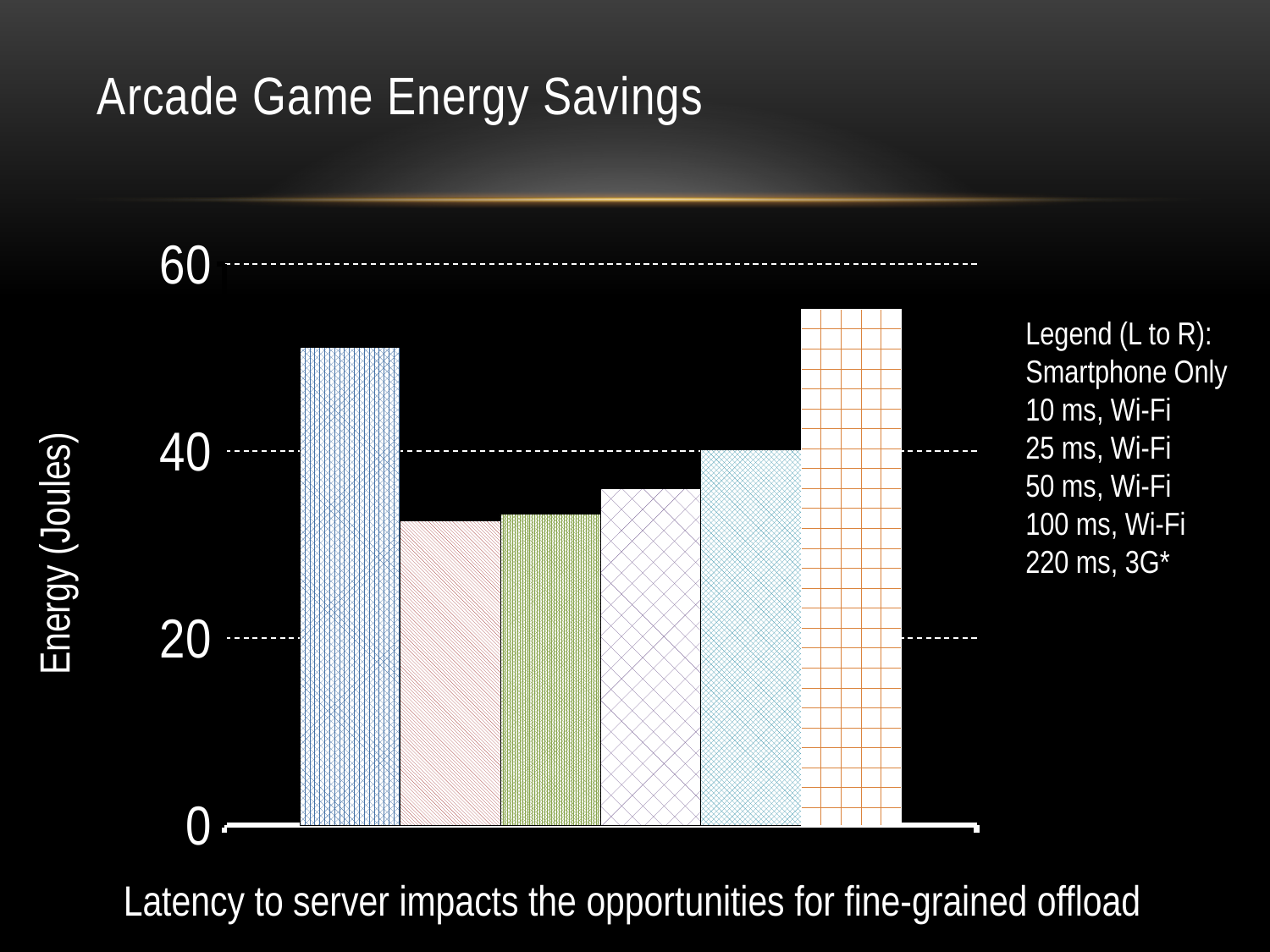
Is the energy value for Smartphone Only greater or less than 40? greater Is the energy value for 220 ms, 3G* greater or less than 60? less Which configuration has the highest energy value in the chart? 220 ms, 3G* Which has the larger energy value, 50 ms, Wi-Fi or 220 ms, 3G*? 220 ms, 3G* How many bars are plotted in the chart? 6 What is the label of the vertical axis of the chart? Energy (Joules) Is the energy value for 220 ms, 3G* greater or less than 40? greater Which has the larger energy value, Smartphone Only or 10 ms, Wi-Fi? Smartphone Only What kind of chart is shown on the slide? bar chart Among the Wi-Fi bars, do the energy values rise or fall as latency increases from 10 ms to 100 ms? rise